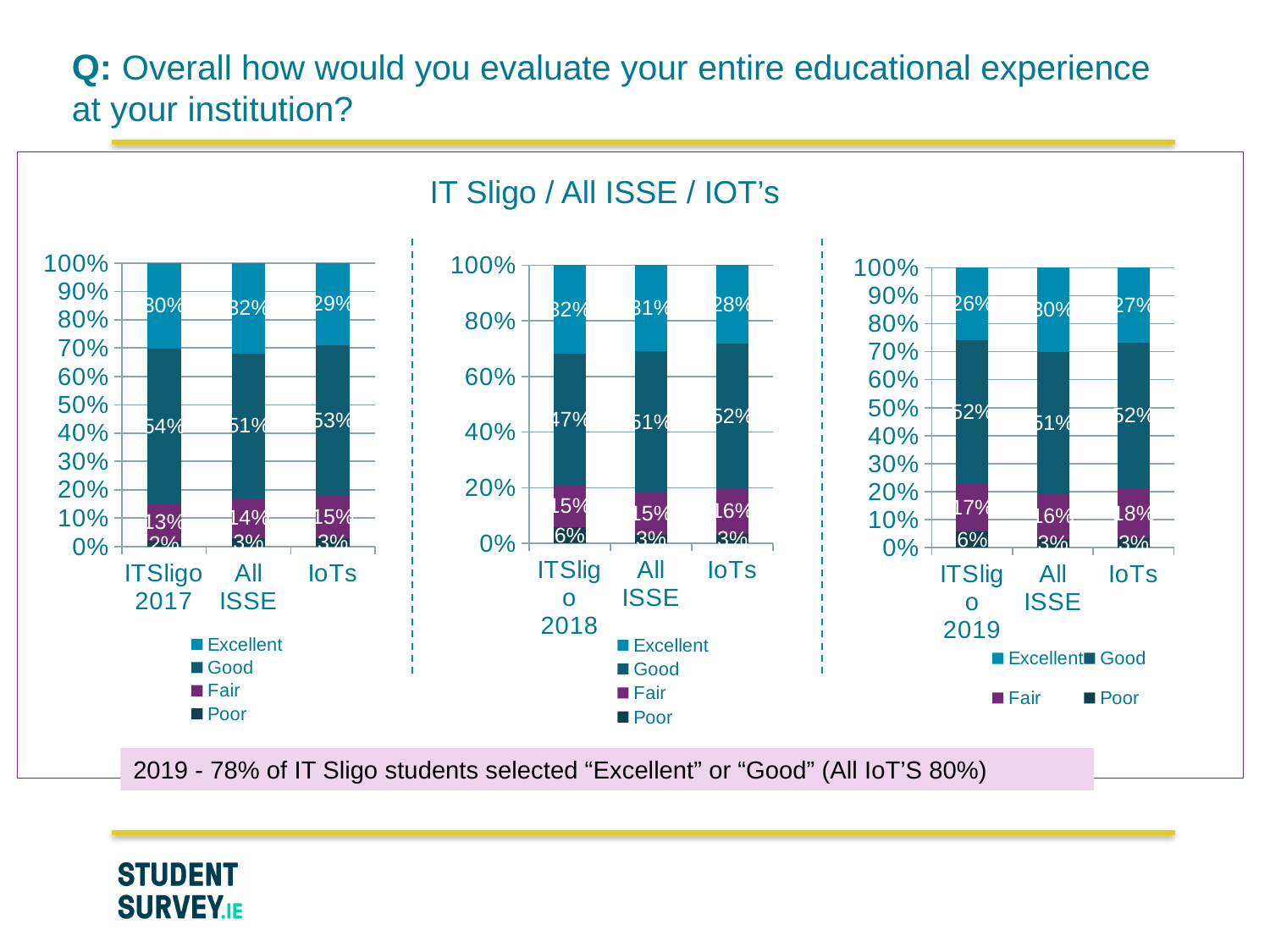
In the 2019 chart, which category has the highest Excellent value? All ISSE In the 2019 chart, what is the Fair value for IoTs? 18% In the 2019 chart, which category has the lowest Excellent value? ITSligo 2019 In the 2018 chart, what percentage of ITSligo 2018 students selected Good? 47% What kind of chart is used for the 2017 chart on the left? Stacked bar chart In the 2019 chart, what is the Poor value for ITSligo 2019? 6% How many series does the legend of the 2018 chart list? 4 In the 2017 chart, what is the Fair value for IoTs? 15% In the 2018 chart, what is the difference between the Good value for IoTs and the Good value for ITSligo 2018? 5 percentage points In the 2017 chart, which has the larger Good value: ITSligo 2017 or All ISSE? ITSligo 2017 What is the title shown above the three charts? IT Sligo / All ISSE / IOT’s How many categories are shown on the x axis of the 2019 chart? 3